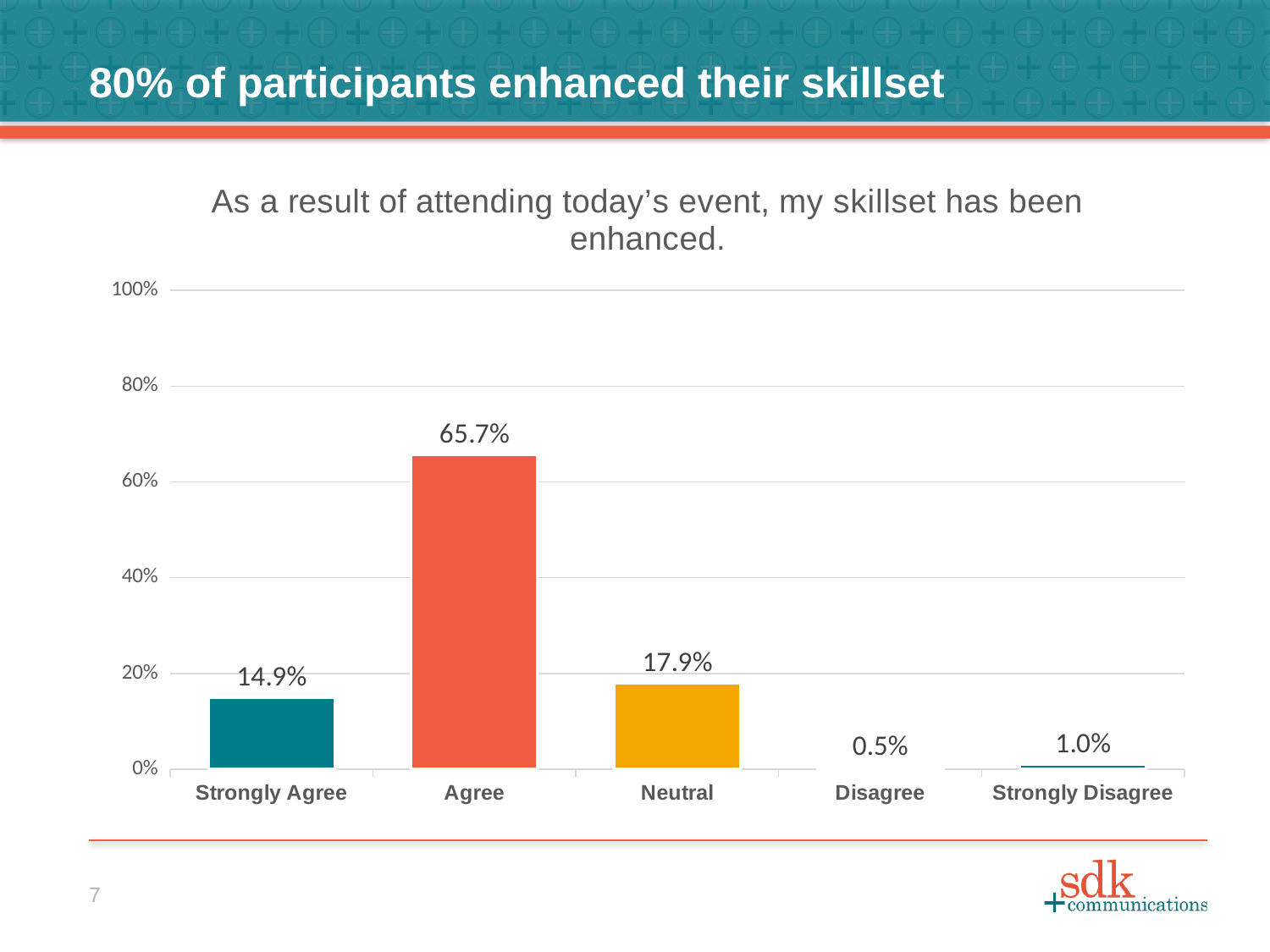
Which is larger, the value for Neutral or the value for Strongly Agree? Neutral Which response category has the lowest value? Disagree What is the title of the chart? As a result of attending today's event, my skillset has been enhanced. What percentage of participants answered Agree? 65.7% What is the value for Neutral? 17.9% Which response category has the highest value? Agree Is the value for Agree greater or less than 60%? greater What is the difference between the Agree and Neutral values? 47.8% What kind of chart is shown on the slide? Bar chart What is the value for Strongly Disagree? 1.0% What is the value for Strongly Agree? 14.9% How many response categories are shown on the x axis? 5